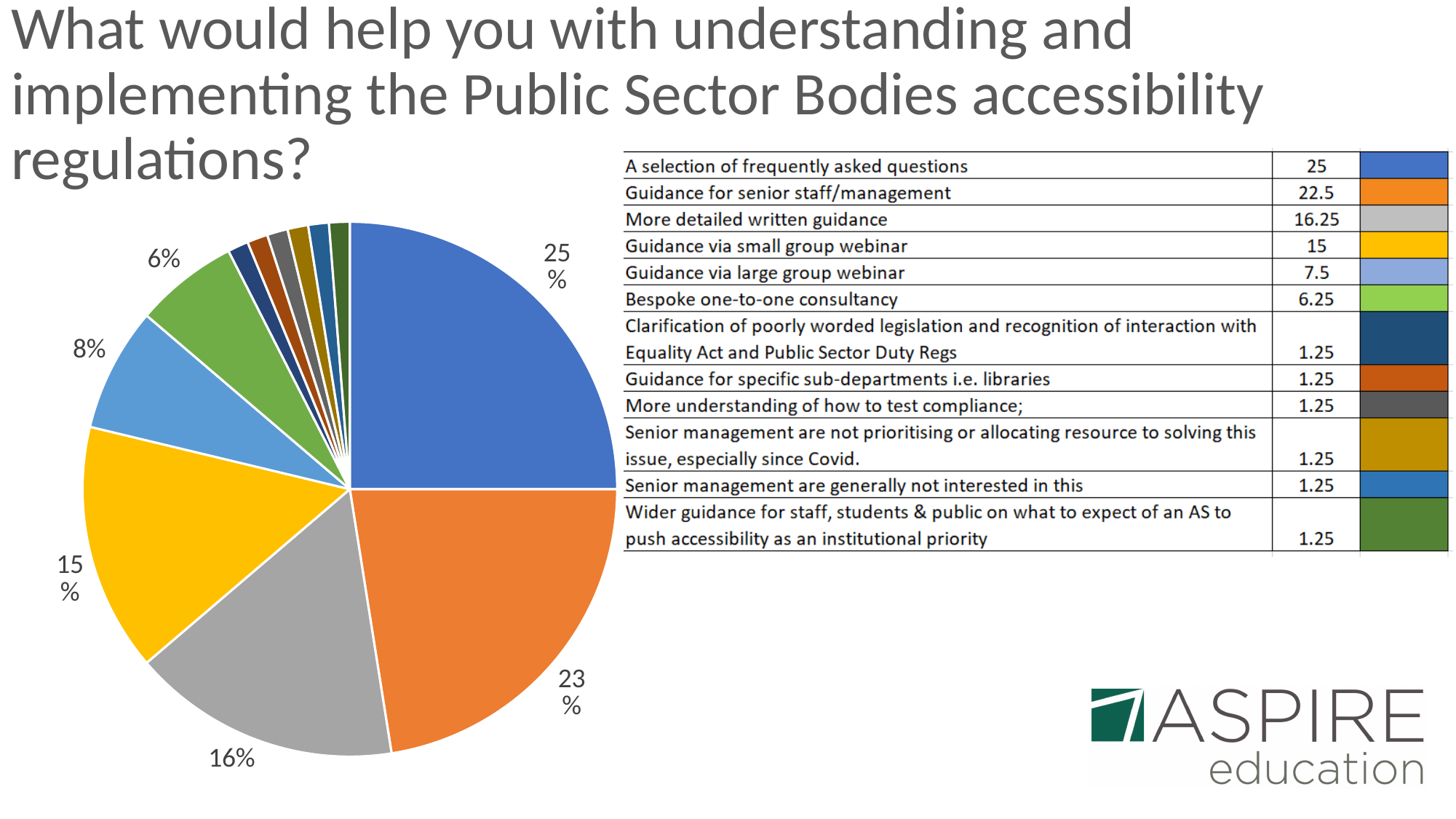
Which category has the largest slice of the pie? A selection of frequently asked questions What percentage label is shown on the pie slice for 'Guidance for senior staff/management'? 23% What colour is the slice for 'Guidance via small group webinar'? yellow What type of chart is shown on the slide? pie chart How many categories (slices) does the pie chart have? 12 What percentage label is shown on the pie slice for 'A selection of frequently asked questions'? 25% What percentage label is shown on the pie slice for 'More detailed written guidance'? 16% What percentage label is shown on the pie slice for 'Guidance via small group webinar'? 15% What percentage label is shown on the pie slice for 'Bespoke one-to-one consultancy'? 6% What is the difference between the pie labels for 'A selection of frequently asked questions' (25%) and 'More detailed written guidance' (16%)? 9% Which slice is larger: 'Guidance via small group webinar' or 'Guidance via large group webinar'? Guidance via small group webinar What value does the table give for 'Guidance via large group webinar'? 7.5